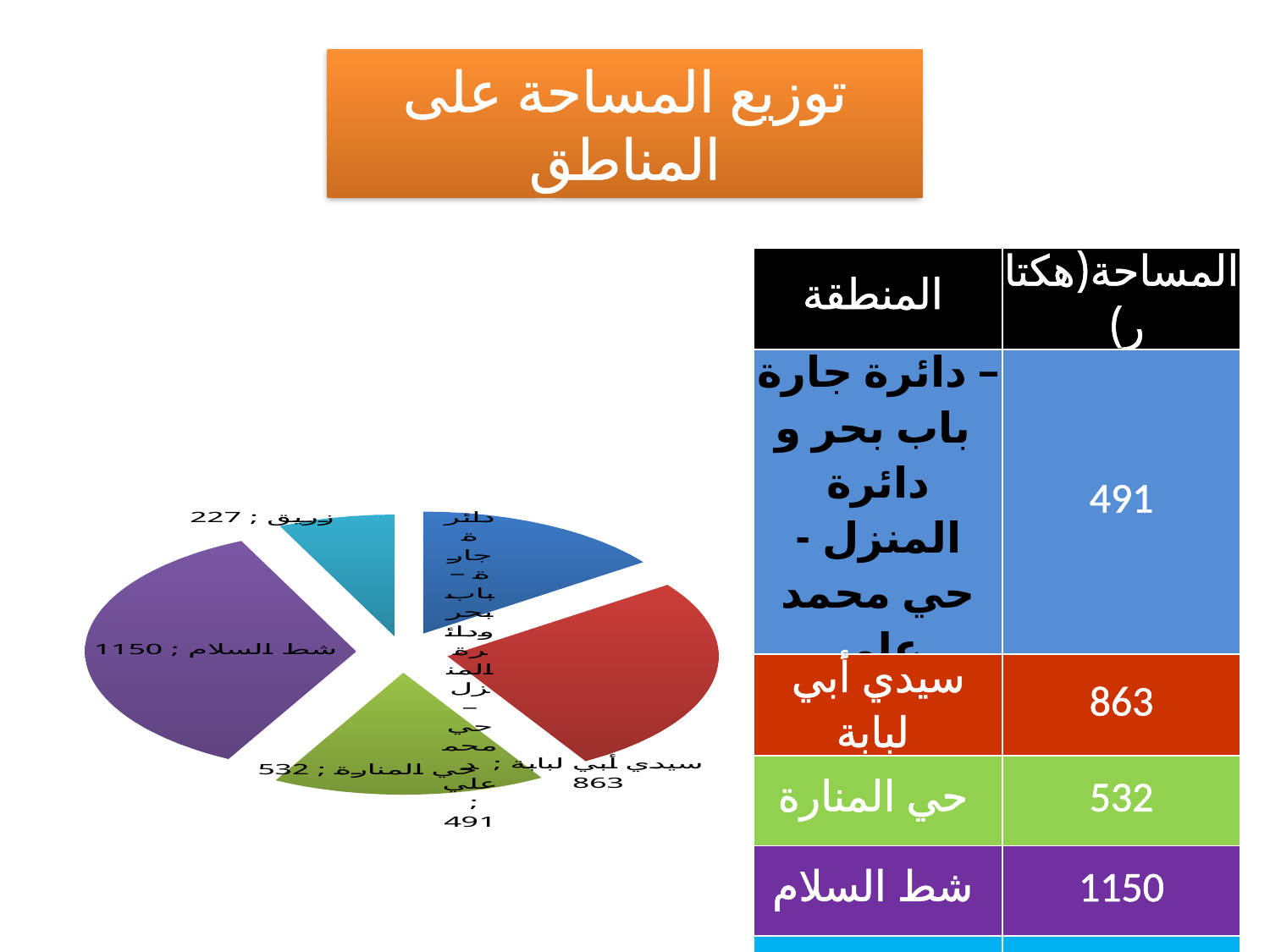
What is the value for زريق in the pie chart? 227 What is the difference between the values for شط السلام and سيدي أبي لبابة? 287 What is the title of the slide containing the pie chart? توزيع المساحة على المناطق What is the difference between the values for حي المنارة and زريق? 305 Which region has the largest slice in the pie chart? شط السلام Which is larger, the value for سيدي أبي لبابة or the value for حي المنارة? سيدي أبي لبابة How many slices does the pie chart have? 5 What kind of chart is shown on the slide? pie chart What is the value for شط السلام in the pie chart? 1150 What is the value for سيدي أبي لبابة in the pie chart? 863 Which region has the smallest slice in the pie chart? زريق What is the value for حي المنارة in the pie chart? 532